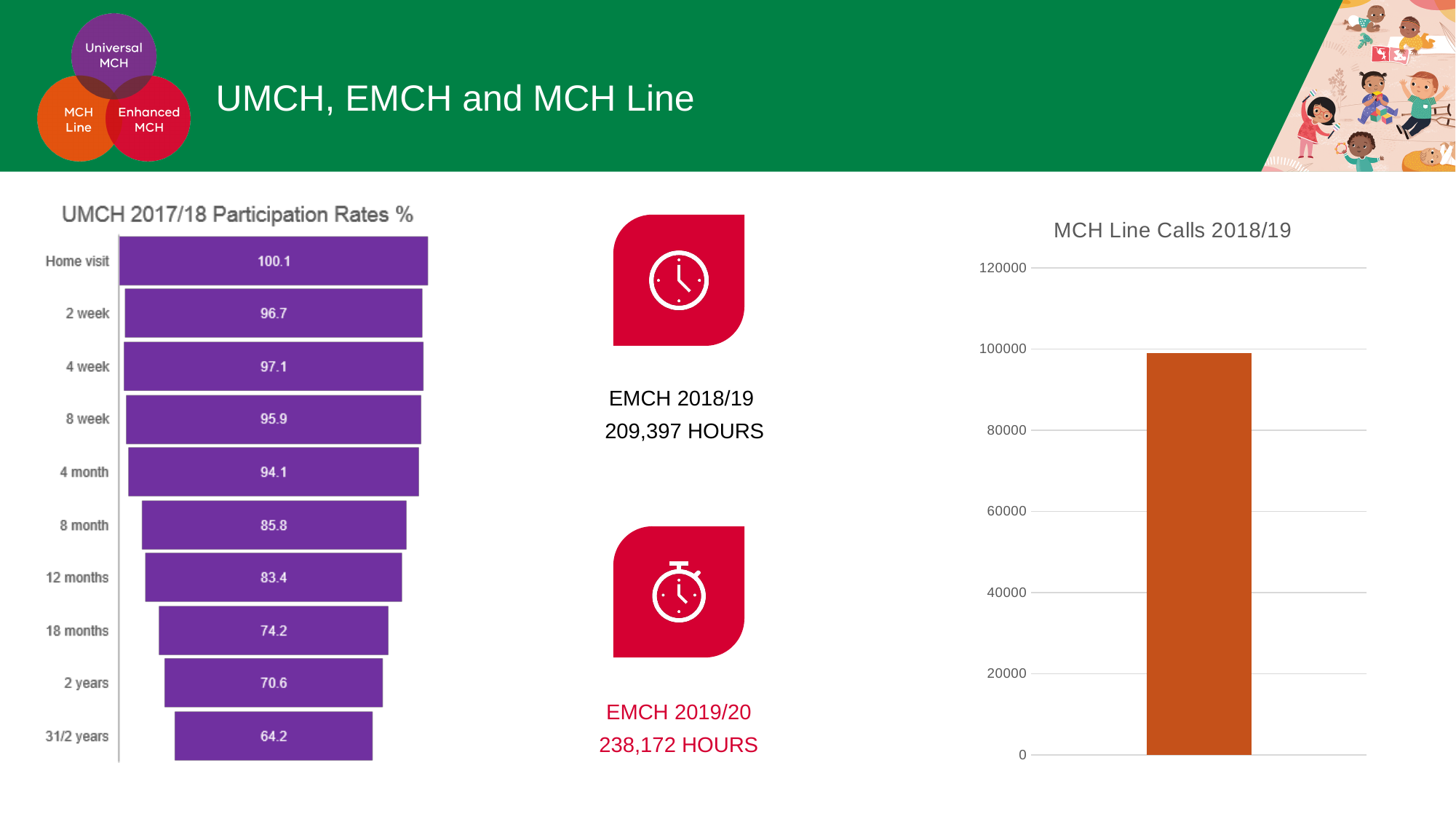
In the MCH Line Calls 2018/19 chart, is the value of the bar greater or less than 120000? less How many categories are shown in the UMCH 2017/18 Participation Rates % chart? 10 In the UMCH 2017/18 Participation Rates % chart, what is the value for 18 months? 74.2 In the UMCH 2017/18 Participation Rates % chart, which category has the highest value? Home visit In the MCH Line Calls 2018/19 chart, is the value of the bar greater or less than 80000? greater In the UMCH 2017/18 Participation Rates % chart, which category has the lowest value? 31/2 years In the UMCH 2017/18 Participation Rates % chart, what is the difference between the values for 2 week and 2 years? 26.1 In the UMCH 2017/18 Participation Rates % chart, what is the value for 8 week? 95.9 In the UMCH 2017/18 Participation Rates % chart, which is larger, the value for 4 week or the value for 4 month? 4 week In the UMCH 2017/18 Participation Rates % chart, do the values generally rise or fall from Home visit down to 31/2 years? Fall What kind of chart is the UMCH 2017/18 Participation Rates % chart? Bar chart How many bars are shown in the MCH Line Calls 2018/19 chart? 1